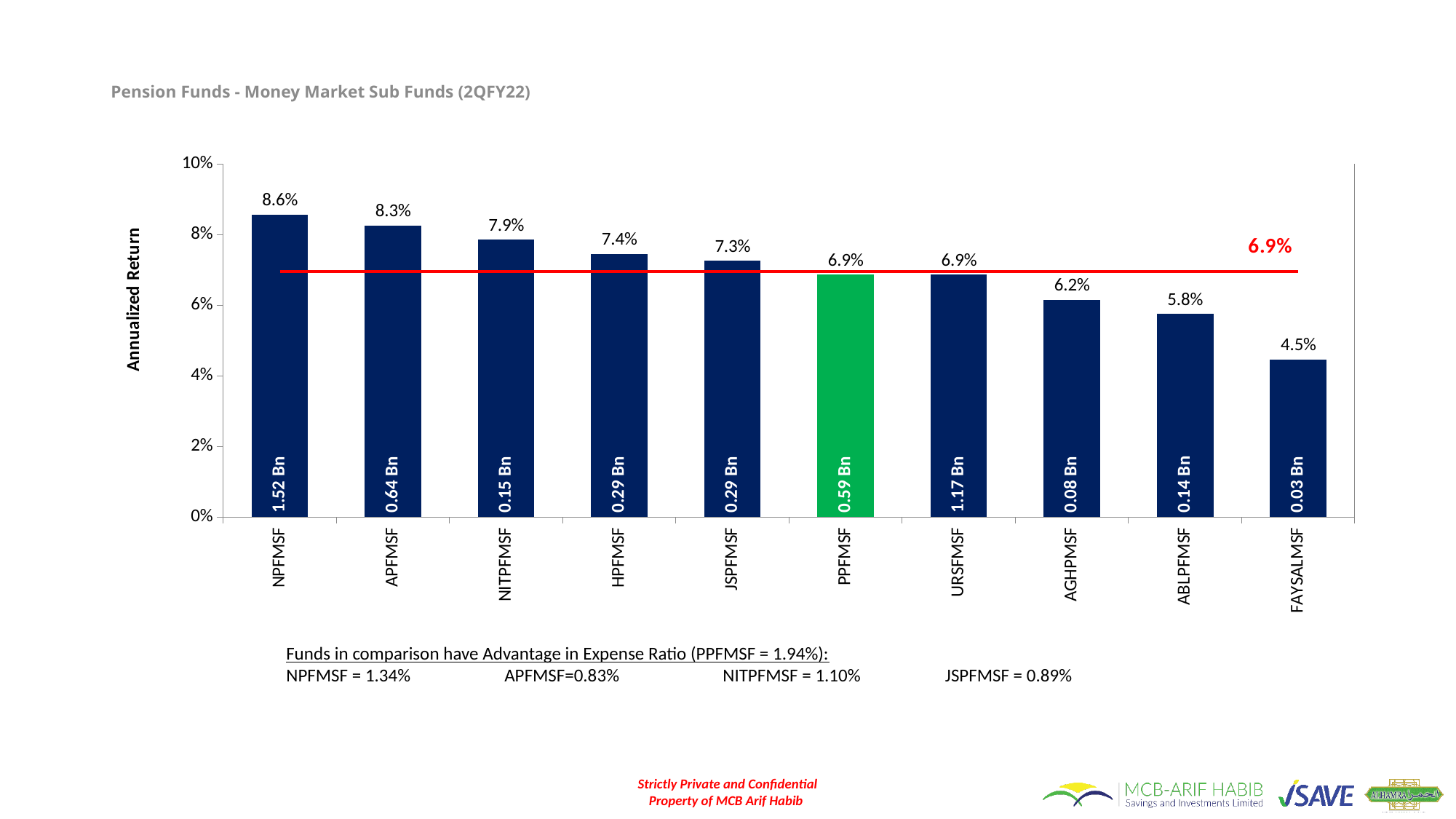
Which fund has the lowest annualized return? FAYSALMSF Which has a higher annualized return, APFMSF or HPFMSF? APFMSF How many funds are shown on the chart? 10 What is the difference in annualized return between NPFMSF and FAYSALMSF? 4.1% What is the annualized return for FAYSALMSF? 4.5% What kind of chart is shown on the slide? bar chart Which fund has the highest annualized return? NPFMSF What value is labelled on the red horizontal line? 6.9% Is the annualized return for ABLPFMSF greater or less than 6%? less What is the annualized return for NPFMSF? 8.6% What is the annualized return for AGHPMSF? 6.2% What fund size is printed inside the PPFMSF bar? 0.59 Bn